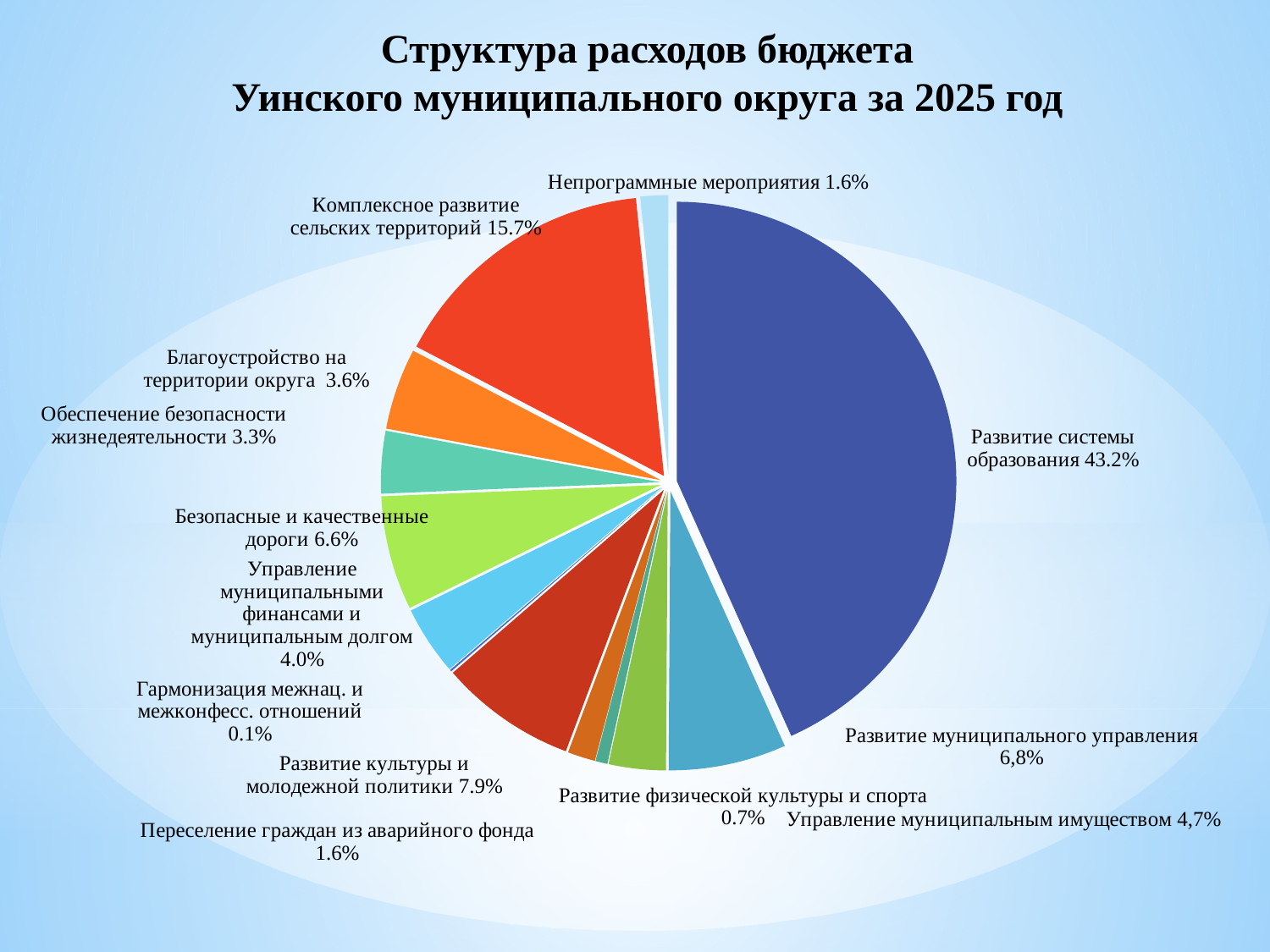
What percentage is shown for Управление муниципальным имуществом? 4,7% What kind of chart is shown on the slide? pie chart What percentage is shown for Гармонизация межнац. и межконфесс. отношений? 0.1% What year does the chart title say the budget expenditure structure refers to? 2025 Which category has the largest share of the budget expenditure? Развитие системы образования Which category has the smallest share of the budget expenditure? Гармонизация межнац. и межконфесс. отношений What percentage is shown for Комплексное развитие сельских территорий? 15.7% Which has a larger share: Безопасные и качественные дороги or Развитие муниципального управления? Развитие муниципального управления What percentage is shown for Развитие культуры и молодежной политики? 7.9% What share of the budget expenditure goes to Развитие системы образования? 43.2% What is the difference in percentage points between Развитие системы образования and Комплексное развитие сельских территорий? 27.5 How many categories are labeled on the pie chart? 13